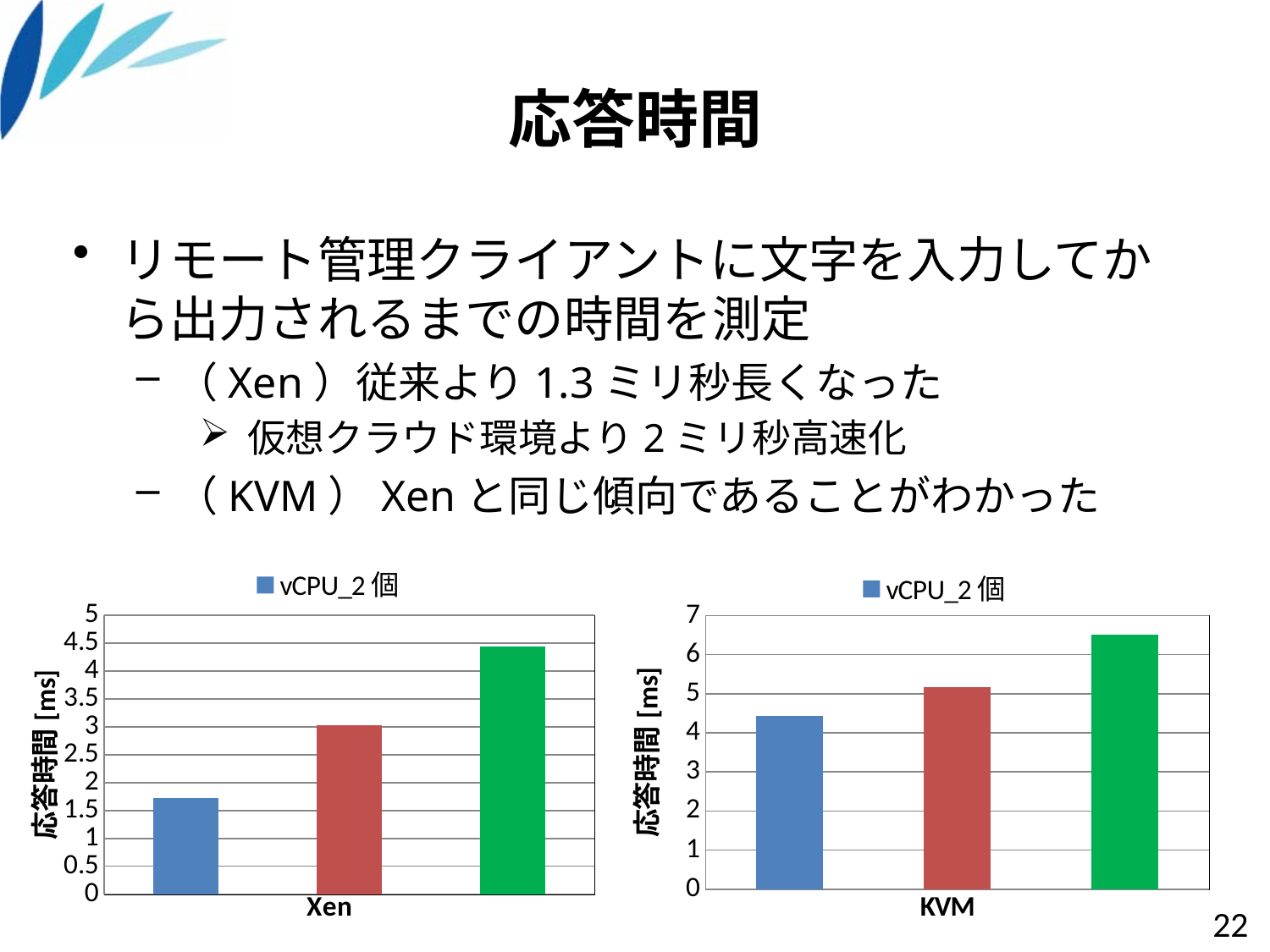
In the right chart labelled KVM, do the bar values rise or fall from left to right? rise What is the y-axis label of the right chart labelled KVM? 応答時間 [ms] In the left chart labelled Xen, is the value of the green bar greater or less than 4? greater In the right chart labelled KVM, is the value of the green bar greater or less than 6? greater In the right chart labelled KVM, how many bars are plotted? 3 In the left chart labelled Xen, how many bars are plotted? 3 What kind of chart is the left chart labelled Xen? bar chart In the left chart labelled Xen, which bar is the shortest? the blue bar In the left chart labelled Xen, which bar is the tallest? the green bar In the left chart labelled Xen, is the value of the blue bar greater or less than 2? less In the right chart labelled KVM, which bar is the tallest? the green bar How many series does the legend of the left chart labelled Xen list? 1